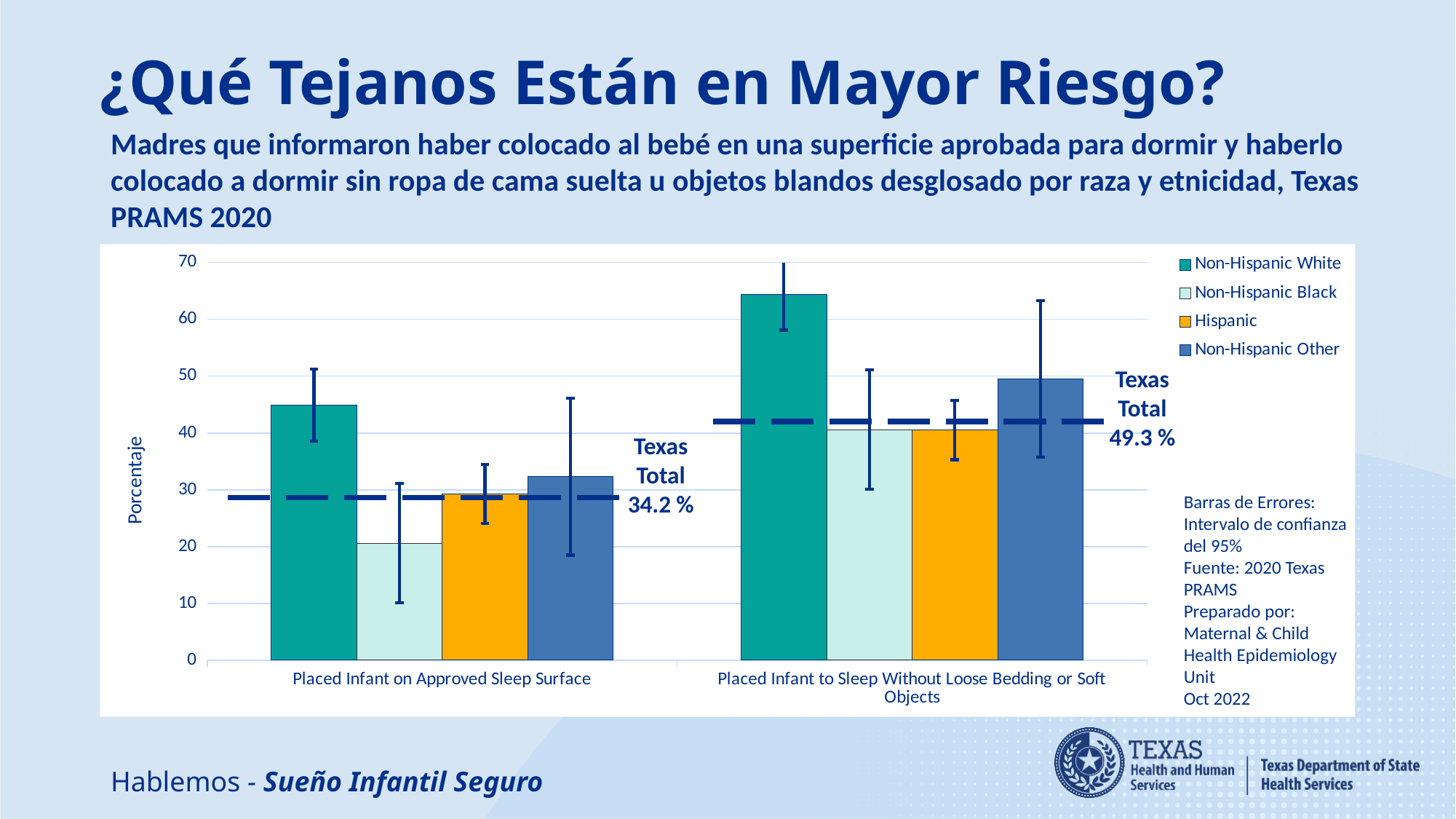
How many series does the legend list? 4 For "Placed Infant on Approved Sleep Surface", which is larger: the Hispanic bar or the Non-Hispanic Black bar? Hispanic Which group has the highest bar for "Placed Infant on Approved Sleep Surface"? Non-Hispanic White Is the Non-Hispanic Black value for "Placed Infant on Approved Sleep Surface" greater or less than 30? less What is the Texas Total printed for "Placed Infant to Sleep Without Loose Bedding or Soft Objects"? 49.3 % Which group has the highest bar for "Placed Infant to Sleep Without Loose Bedding or Soft Objects"? Non-Hispanic White What kind of chart is shown on the slide? bar chart Is the Non-Hispanic White value for "Placed Infant to Sleep Without Loose Bedding or Soft Objects" greater or less than 60? greater How many categories are shown on the x axis? 2 What colour represents Hispanic in the legend? orange What is the Texas Total printed for "Placed Infant on Approved Sleep Surface"? 34.2 % Which group has the lowest bar for "Placed Infant on Approved Sleep Surface"? Non-Hispanic Black